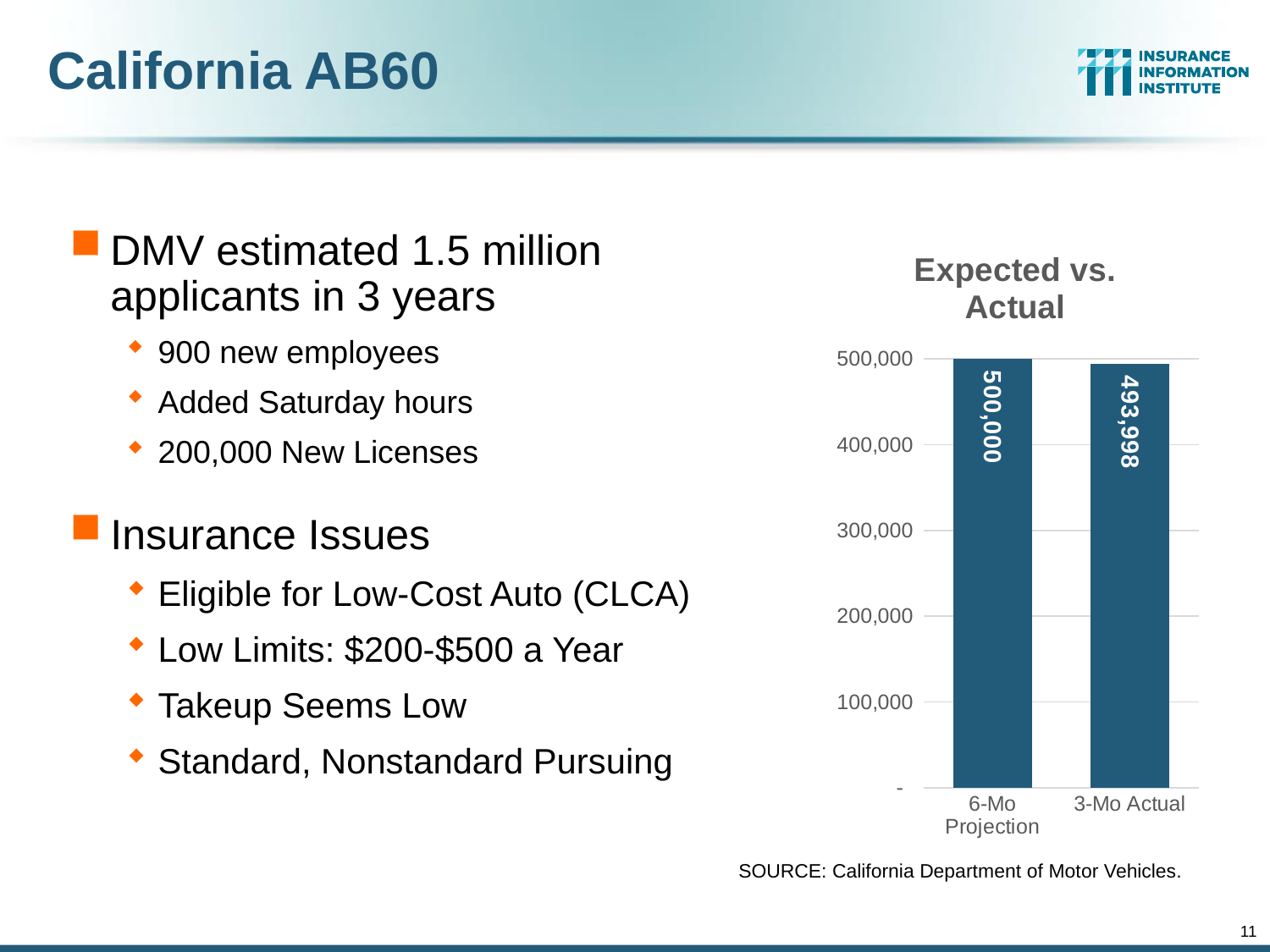
What is the difference between the 6-Mo Projection and the 3-Mo Actual values? 6,002 What is the title of the chart? Expected vs. Actual How many bars are shown in the chart? 2 What is the source cited for the chart? California Department of Motor Vehicles What is the highest value shown on the vertical axis of the chart? 500,000 What is the value for 6-Mo Projection? 500,000 Which category has the higher value, 6-Mo Projection or 3-Mo Actual? 6-Mo Projection What is the value for 3-Mo Actual? 493,998 What kind of chart is shown on the slide? Bar chart Is the value for 3-Mo Actual greater or less than 400,000? greater